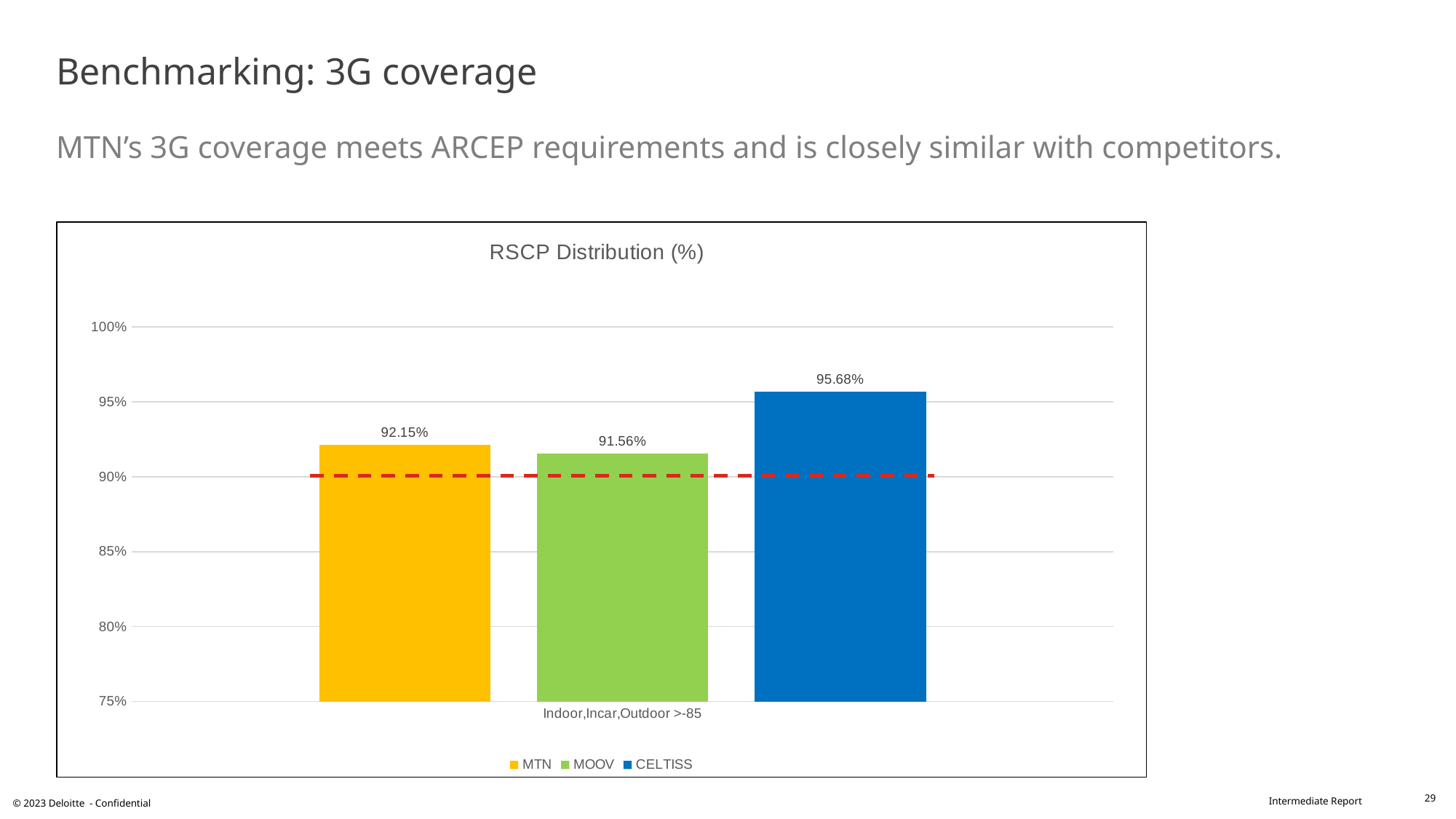
How many series does the legend of the RSCP Distribution (%) chart list? 3 What is the difference between the CELTISS and MTN values in the RSCP Distribution (%) chart? 3.53% What kind of chart is the RSCP Distribution (%) chart? Bar chart Which operator has the lowest RSCP Distribution value? MOOV Which operator has the highest RSCP Distribution value? CELTISS Is the value for CELTISS greater or less than 95%? greater What is the category label shown on the x axis of the RSCP Distribution (%) chart? Indoor,Incar,Outdoor >-85 Is the value for MOOV greater or less than 90%? greater What is the value for CELTISS in the RSCP Distribution (%) chart? 95.68% What is the value for MTN in the RSCP Distribution (%) chart? 92.15% What is the value for MOOV in the RSCP Distribution (%) chart? 91.56% What is the difference between the MTN and MOOV values in the RSCP Distribution (%) chart? 0.59%